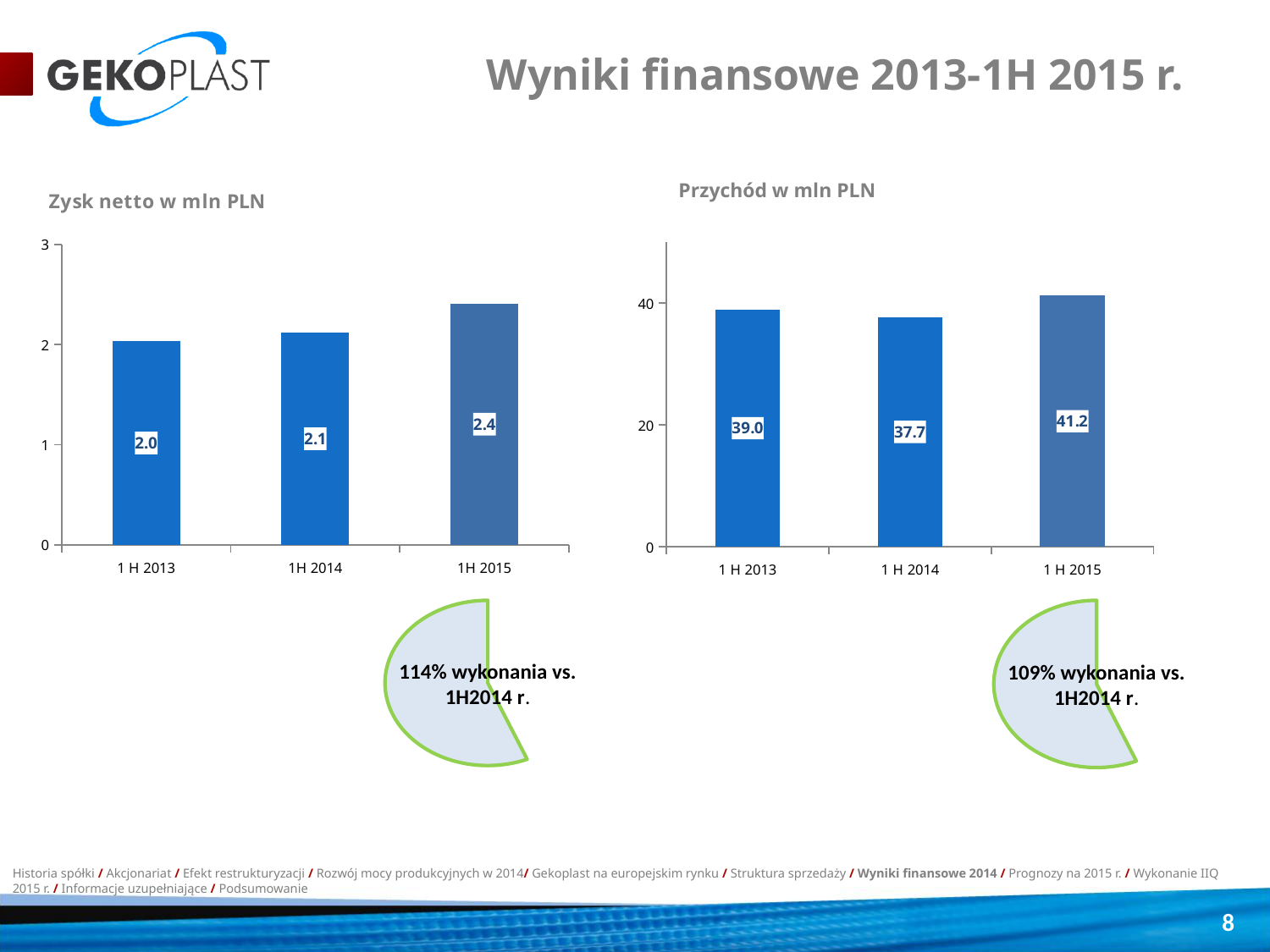
What kind of chart is the 'Zysk netto w mln PLN' chart? bar chart In the 'Przychód w mln PLN' chart, which is larger, the value for 1 H 2013 or 1 H 2014? 1 H 2013 In the 'Zysk netto w mln PLN' chart, do the values rise or fall from 1 H 2013 to 1H 2015? rise In the 'Przychód w mln PLN' chart, what is the value for 1 H 2014? 37.7 In the 'Zysk netto w mln PLN' chart, what is the difference between the values for 1H 2015 and 1 H 2013? 0.4 In the 'Przychód w mln PLN' chart, what is the value for 1 H 2015? 41.2 In the 'Zysk netto w mln PLN' chart, what is the value for 1 H 2013? 2.0 In the 'Zysk netto w mln PLN' chart, what is the value for 1H 2015? 2.4 In the 'Przychód w mln PLN' chart, which period has the lowest value? 1 H 2014 In the 'Zysk netto w mln PLN' chart, which period has the highest value? 1H 2015 In the 'Przychód w mln PLN' chart, what is the difference between the values for 1 H 2015 and 1 H 2014? 3.5 How many bars are shown in the 'Przychód w mln PLN' chart? 3